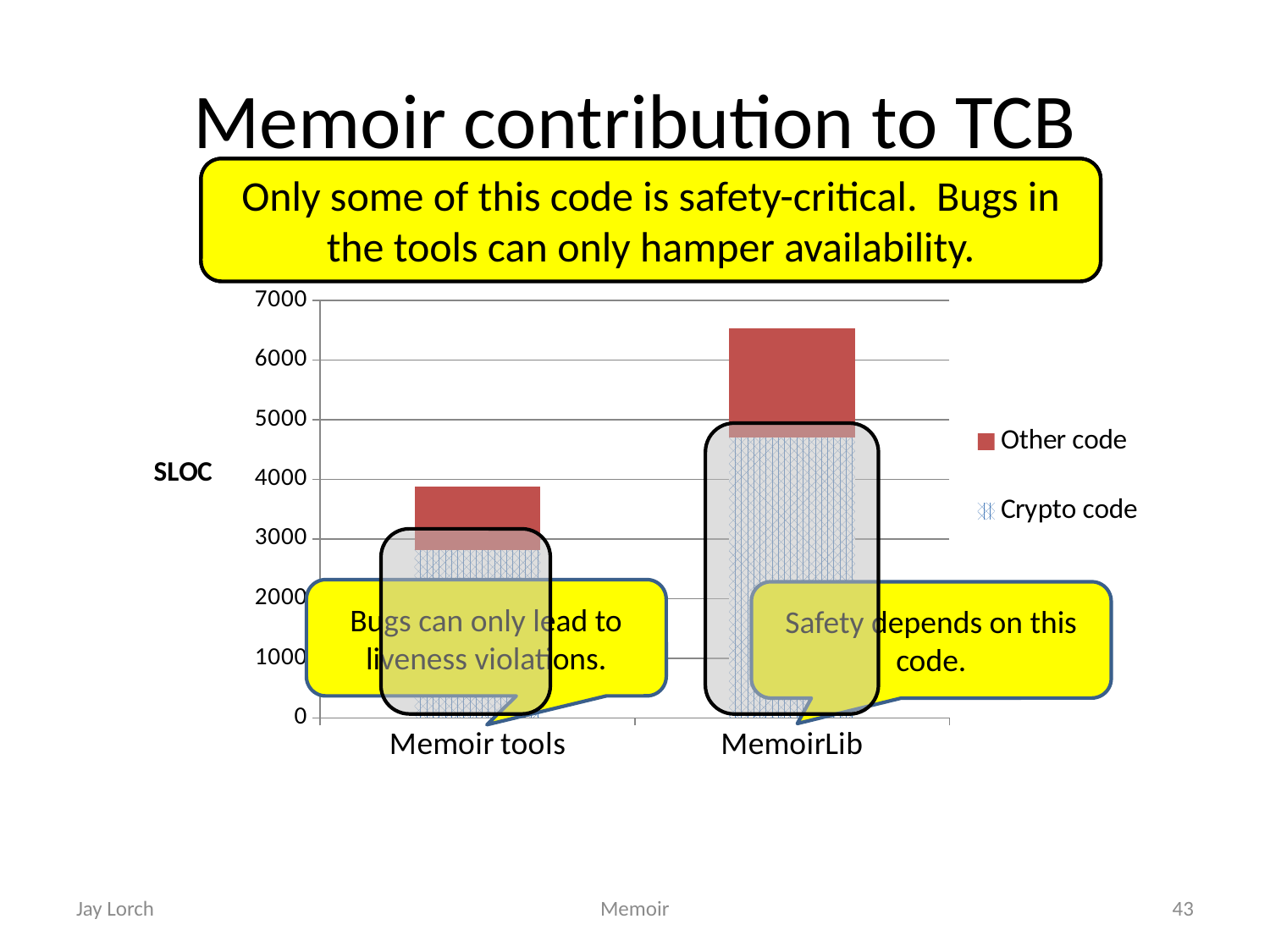
What kind of chart is shown on the slide? bar chart Which category has the taller total bar, Memoir tools or MemoirLib? MemoirLib What is the label on the vertical axis of the chart? SLOC Is the total value for Memoir tools greater or less than 3000? greater Is the total value for MemoirLib greater or less than 6000? greater Which category has the lowest total SLOC? Memoir tools How many categories are shown on the x axis of the chart? 2 What are the two series named in the chart's legend? Other code and Crypto code How many series does the chart's legend list? 2 Is the total value for Memoir tools greater or less than 4000? less Which category has the highest total SLOC? MemoirLib